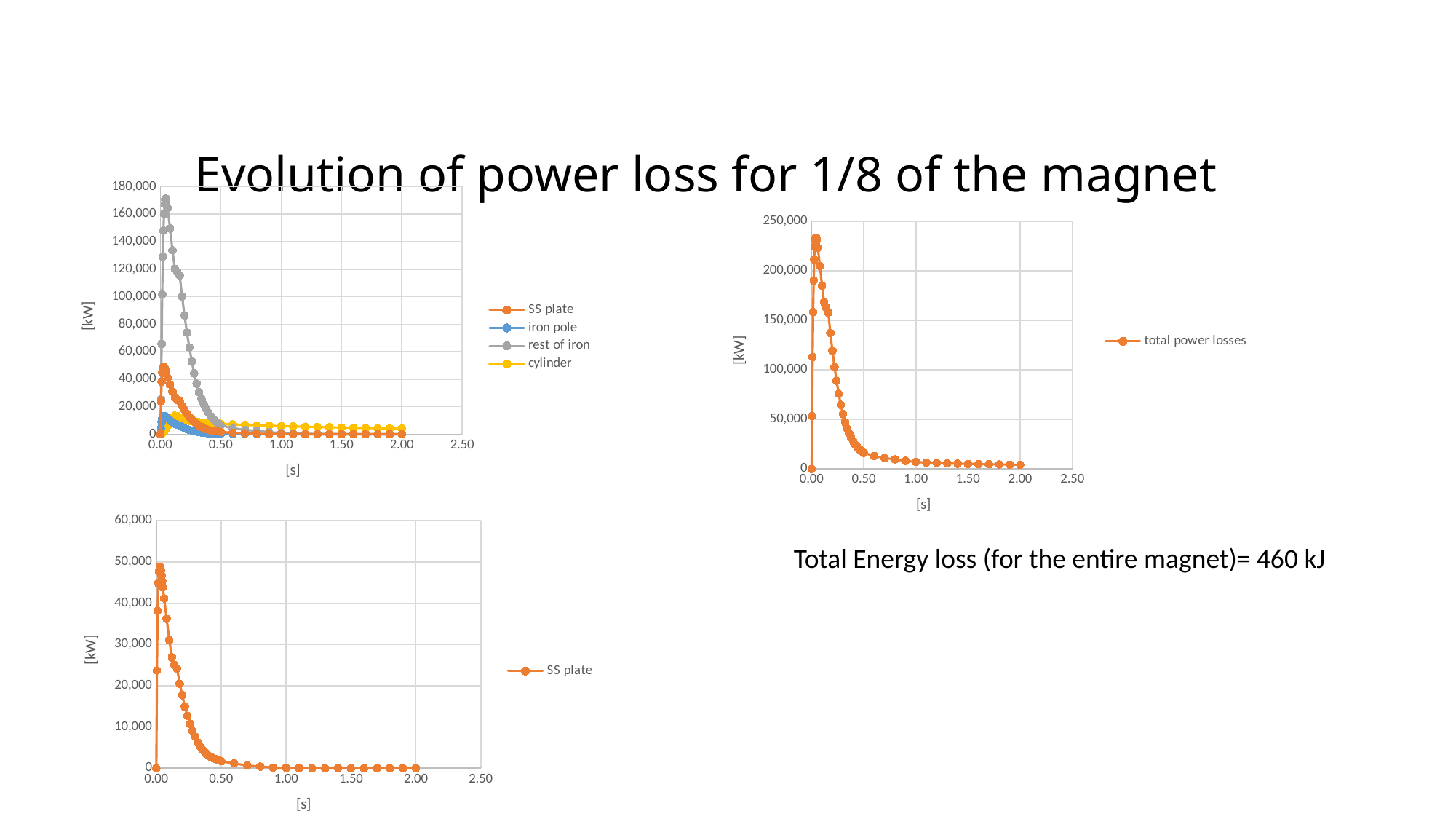
In the top-right chart, is the peak value of total power losses greater or less than 200,000? greater What is the y-axis label of the top-right chart? [kW] What is the x-axis label of the bottom-left chart? [s] In the top-left chart, is the peak value for rest of iron greater or less than 160,000? greater In the bottom-left chart, is the peak value for SS plate greater or less than 40,000? greater In the top-left chart, which series has the larger peak value, rest of iron or SS plate? rest of iron How many series does the legend of the top-left chart list? 4 How many series does the legend of the bottom-left chart list? 1 In the top-right chart, do the total power losses rise or fall along the x axis after the initial peak? fall What kind of chart is the top-right chart titled 'total power losses'? line chart In the top-left chart, which series reaches the highest peak value? rest of iron